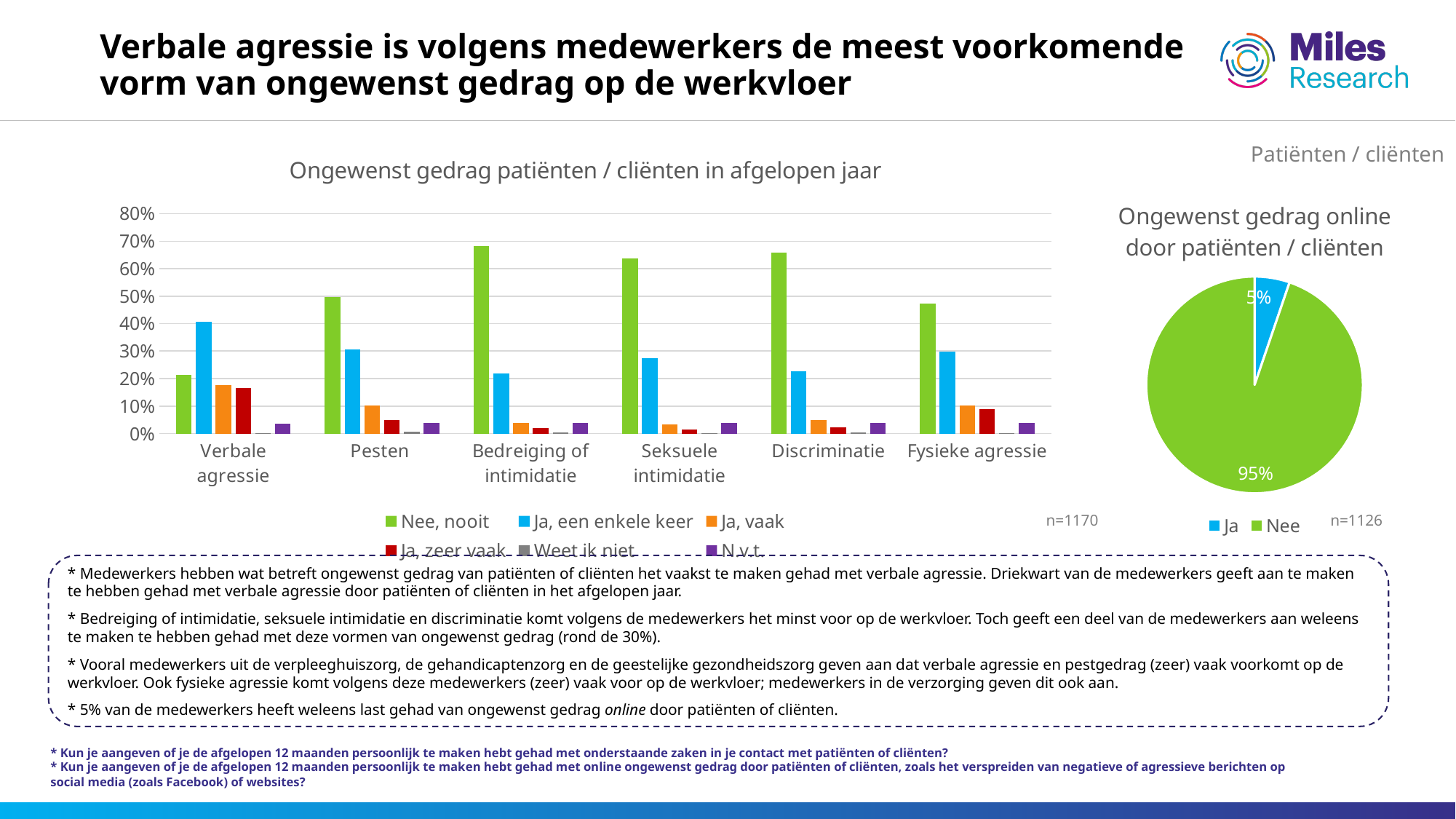
In the bar chart "Ongewenst gedrag patiënten / cliënten in afgelopen jaar", which category has the highest value for "Ja, een enkele keer"? Verbale agressie What kind of chart is "Ongewenst gedrag online door patiënten / cliënten"? pie chart In the pie chart "Ongewenst gedrag online door patiënten / cliënten", what share is labelled for "Nee"? 95% In the bar chart "Ongewenst gedrag patiënten / cliënten in afgelopen jaar", is the value of "Nee, nooit" for "Bedreiging of intimidatie" greater or less than 60%? greater In the bar chart "Ongewenst gedrag patiënten / cliënten in afgelopen jaar", is the value of "Nee, nooit" for "Verbale agressie" greater or less than 30%? less In the pie chart "Ongewenst gedrag online door patiënten / cliënten", which slice is larger, "Ja" or "Nee"? Nee In the bar chart "Ongewenst gedrag patiënten / cliënten in afgelopen jaar", which category has the lowest value for "Nee, nooit"? Verbale agressie In the bar chart "Ongewenst gedrag patiënten / cliënten in afgelopen jaar", which is larger for "Pesten": "Nee, nooit" or "Ja, een enkele keer"? Nee, nooit How many series does the legend of the bar chart "Ongewenst gedrag patiënten / cliënten in afgelopen jaar" list? 6 How many categories are shown on the x axis of the bar chart "Ongewenst gedrag patiënten / cliënten in afgelopen jaar"? 6 What kind of chart is "Ongewenst gedrag patiënten / cliënten in afgelopen jaar"? bar chart In the pie chart "Ongewenst gedrag online door patiënten / cliënten", what share is labelled for "Ja"? 5%